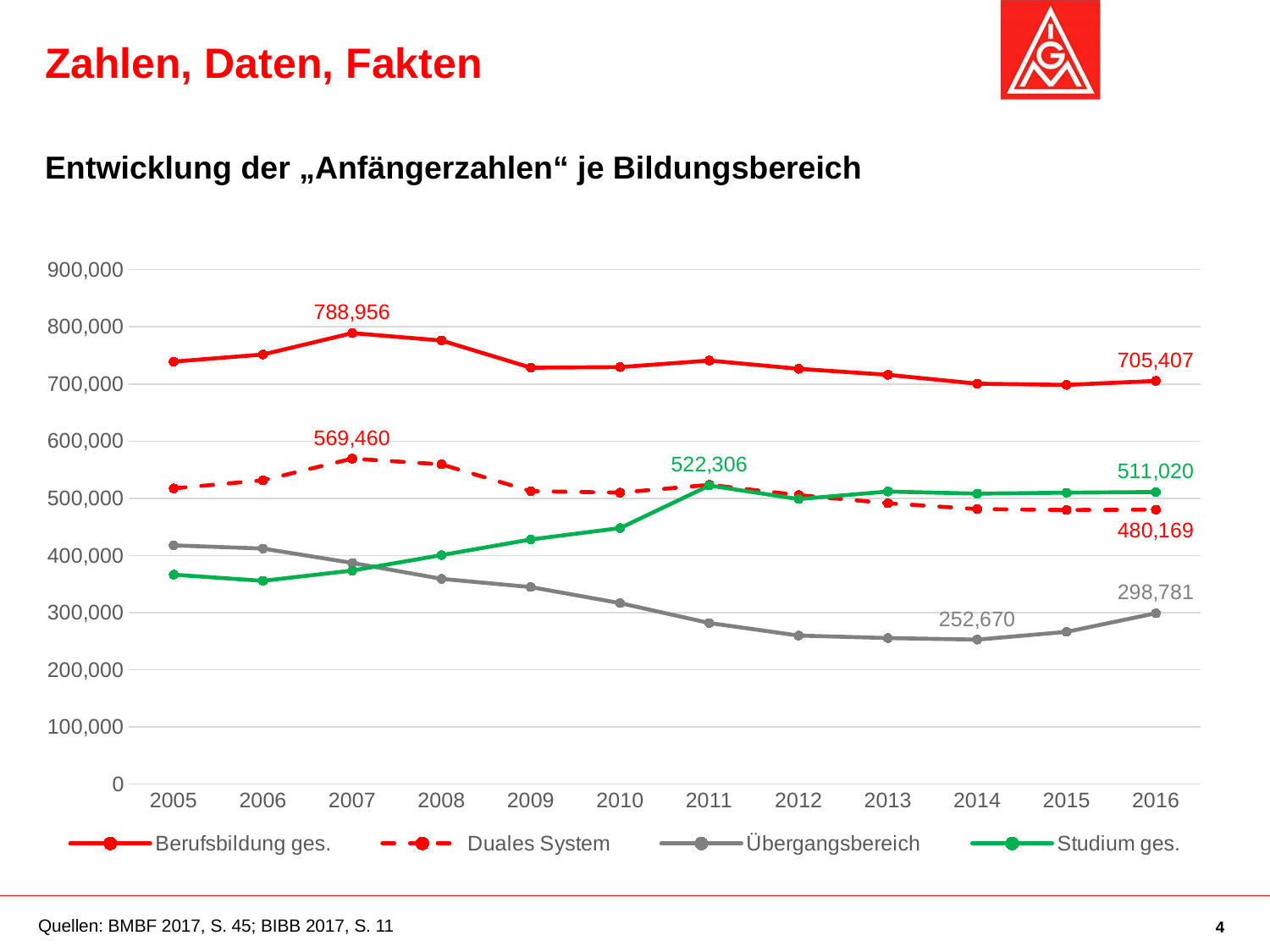
Does the Übergangsbereich series rise or fall from 2005 to 2014? fall Is the value for Übergangsbereich in 2005 greater or less than 400,000? greater Which series has the highest value in 2016? Berufsbildung ges. What is the value for Studium ges. in 2011? 522,306 What is the difference between the Berufsbildung ges. values in 2007 and 2016? 83,549 How many years are shown on the x axis? 12 What kind of chart is shown on the slide? line chart What is the value for Berufsbildung ges. in 2016? 705,407 What is the value for Berufsbildung ges. in 2007? 788,956 What is the value for Übergangsbereich in 2014? 252,670 What is the value for Duales System in 2007? 569,460 How many series does the legend list? 4